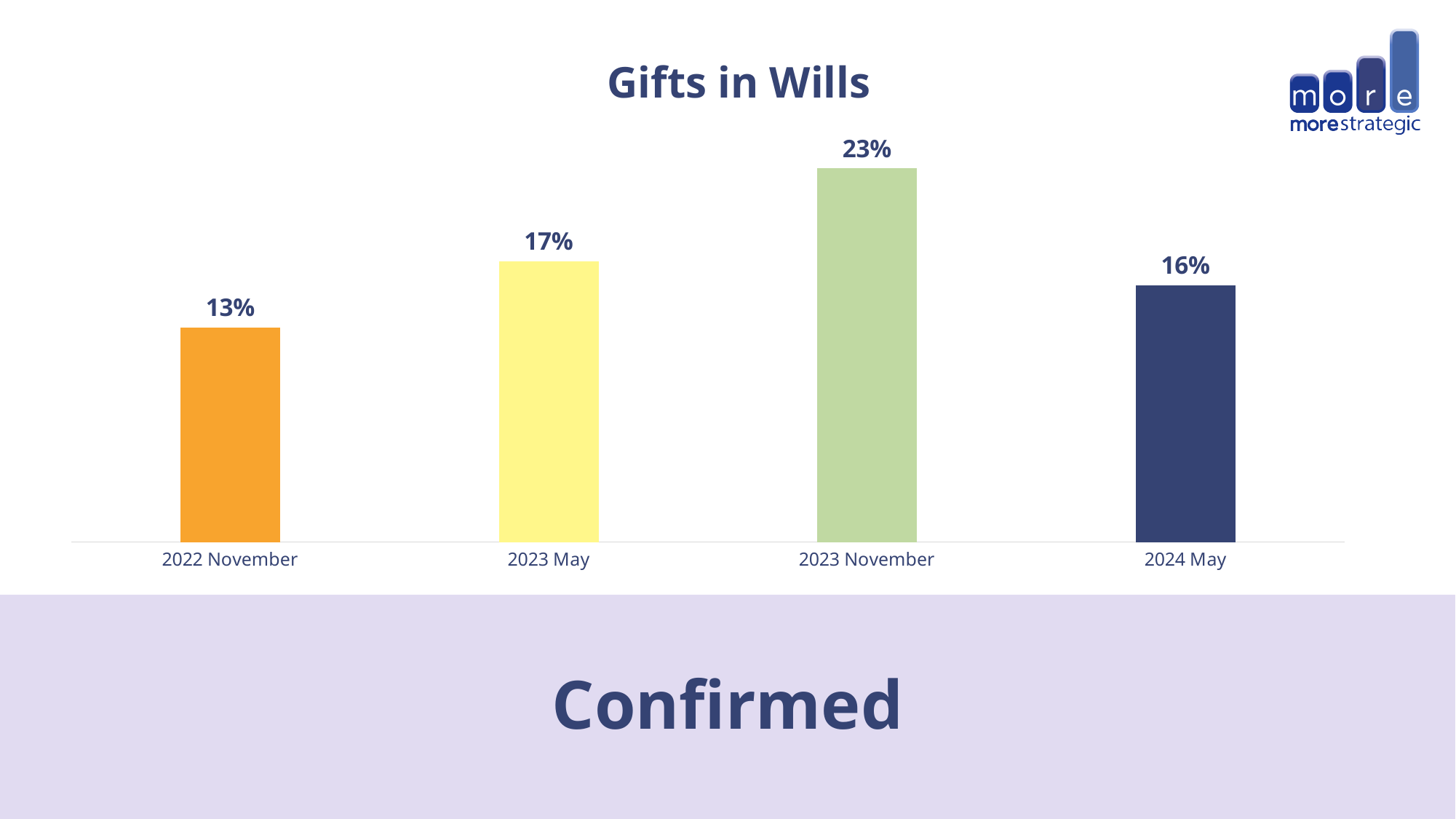
What is the title of the chart? Gifts in Wills What is the difference between the values for 2023 May and 2024 May? 1% Which category has the lowest value? 2022 November Which category has the highest value? 2023 November What kind of chart is this? Bar chart Which is larger, the value for 2023 May or the value for 2022 November? 2023 May What is the value for 2023 May? 17% How many categories are shown on the x axis? 4 What is the difference between the values for 2023 November and 2022 November? 10% What is the value for 2022 November? 13% What is the value for 2023 November? 23% What is the value for 2024 May? 16%